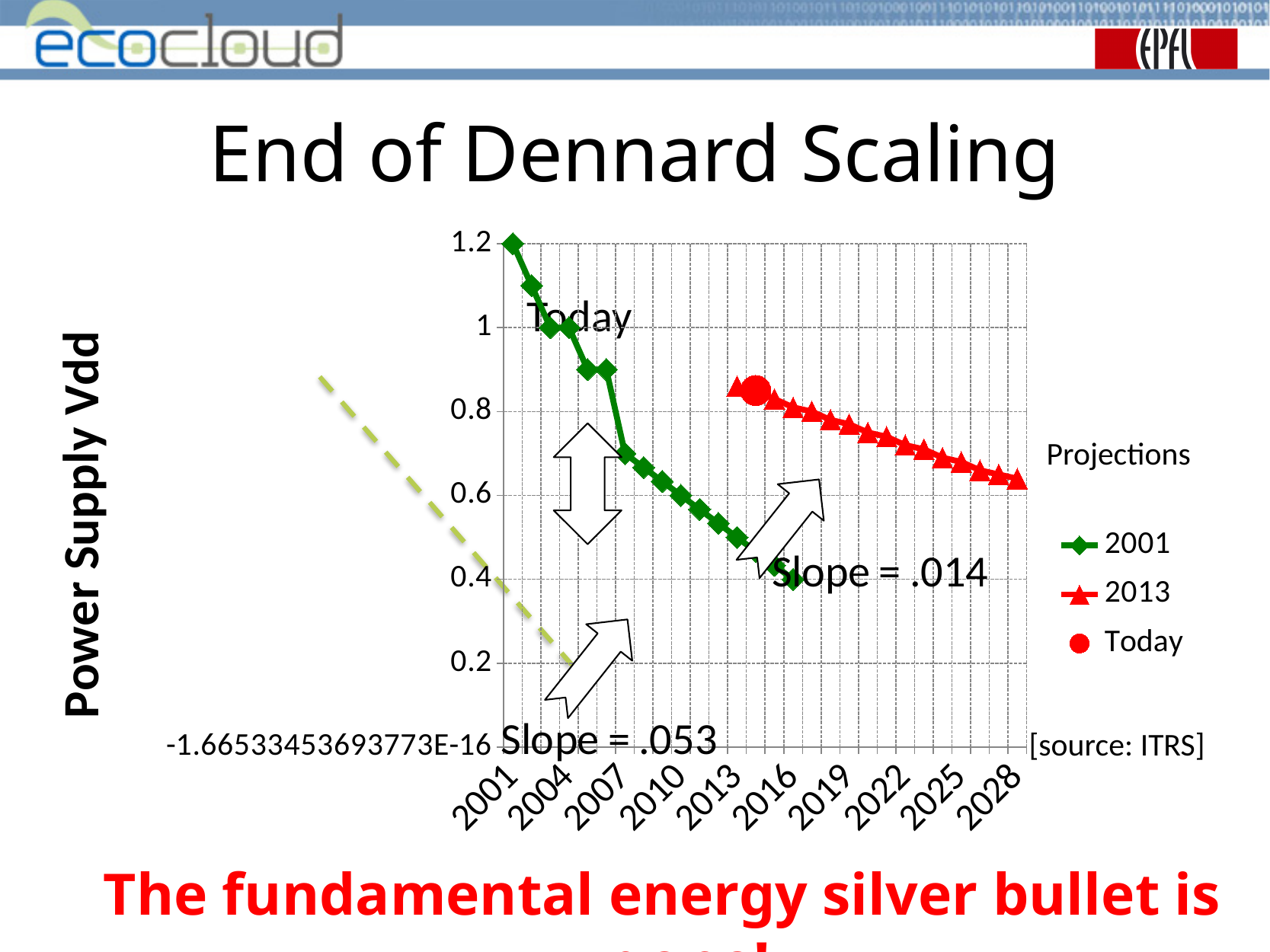
Is the value of the 2013 series at 2028 greater or less than 0.8? less Does the 2013 series rise or fall from 2013 to 2028? fall What kind of chart is shown on the slide? line chart What source is cited for the chart data? ITRS What is the title of the vertical axis? Power Supply Vdd What slope is annotated for the 2013 projection line? .014 Does the 2001 series rise or fall as the years increase? fall Is the value of the 2001 series at 2010 greater or less than 0.8? less What is the value of the 2001 series in the year 2001? 1.2 Around 2013, which series has the higher Vdd value, 2001 or 2013? 2013 How many entries does the chart legend list? 3 In which year does the 2001 series reach its highest value? 2001